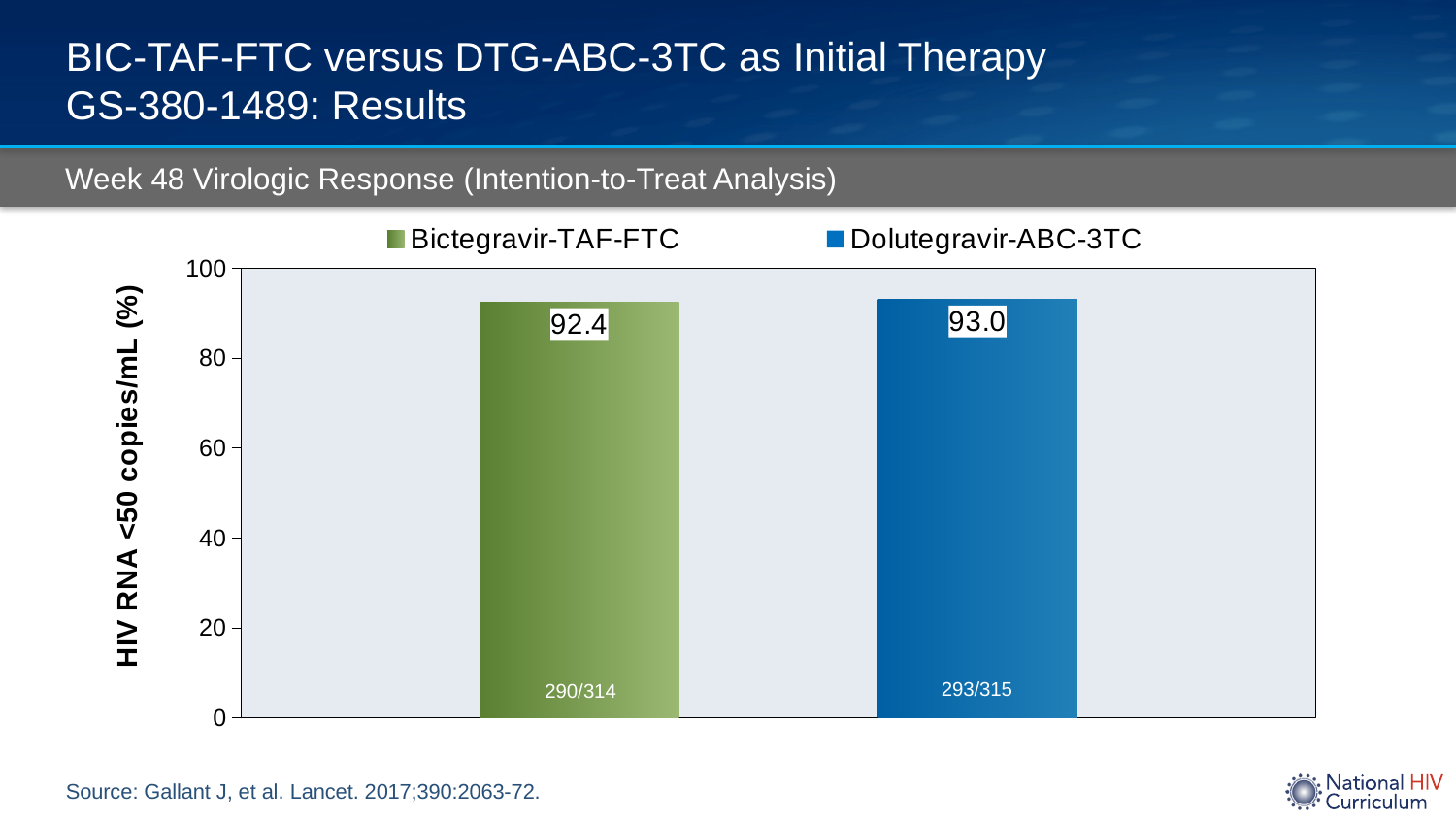
Is the value for Bictegravir-TAF-FTC greater or less than 80? greater How many series does the legend list? 2 What fraction is printed inside the Dolutegravir-ABC-3TC bar? 293/315 What is the label of the y axis? HIV RNA <50 copies/mL (%) What colour is the Dolutegravir-ABC-3TC bar? Blue What is the difference between the Dolutegravir-ABC-3TC and Bictegravir-TAF-FTC values? 0.6 What fraction is printed inside the Bictegravir-TAF-FTC bar? 290/314 How many bars are plotted on the chart? 2 Is the value for Dolutegravir-ABC-3TC greater or less than 100? less What is the value for Bictegravir-TAF-FTC? 92.4 What is the value for Dolutegravir-ABC-3TC? 93.0 What kind of chart is shown on the slide? Bar chart